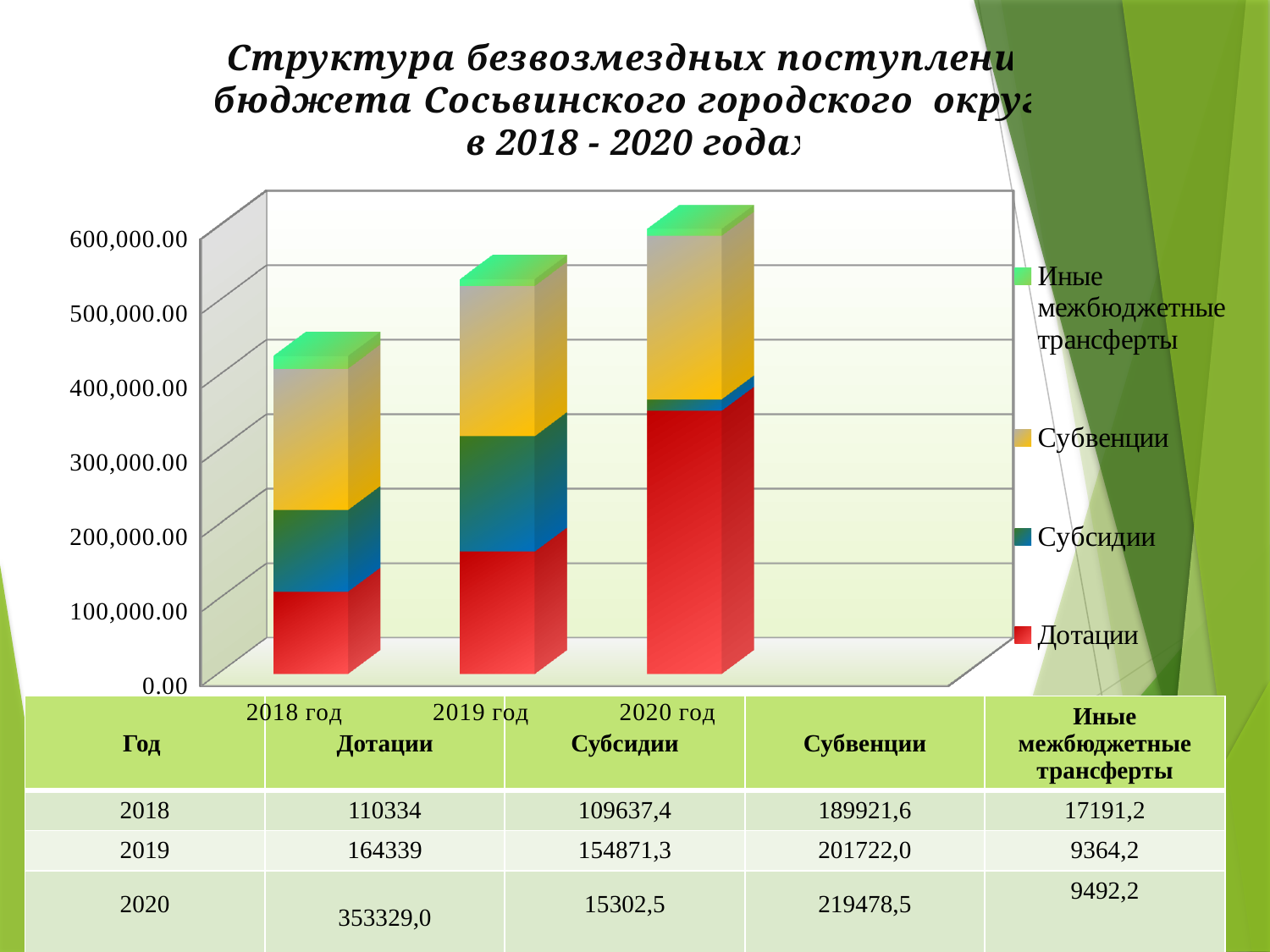
Is the total height of the 2020 stacked bar greater or less than 500,000.00? greater How many series does the chart legend list? 4 Do the total heights of the stacked bars rise or fall from 2018 to 2020? rise How many years (categories) are plotted on the x axis of the chart? 3 What kind of chart is shown on the slide? stacked bar chart In which year is the Дотации value the highest? 2020 In which year is the Субсидии value the lowest? 2020 What is the value of Дотации for 2020? 353329,0 Which is larger, Субвенции in 2020 or Субвенции in 2018? Субвенции in 2020 What is the difference between the Дотации values for 2019 and 2018? 54005 What is the value of Субвенции for 2019? 201722,0 What is the value of Иные межбюджетные трансферты for 2018? 17191,2